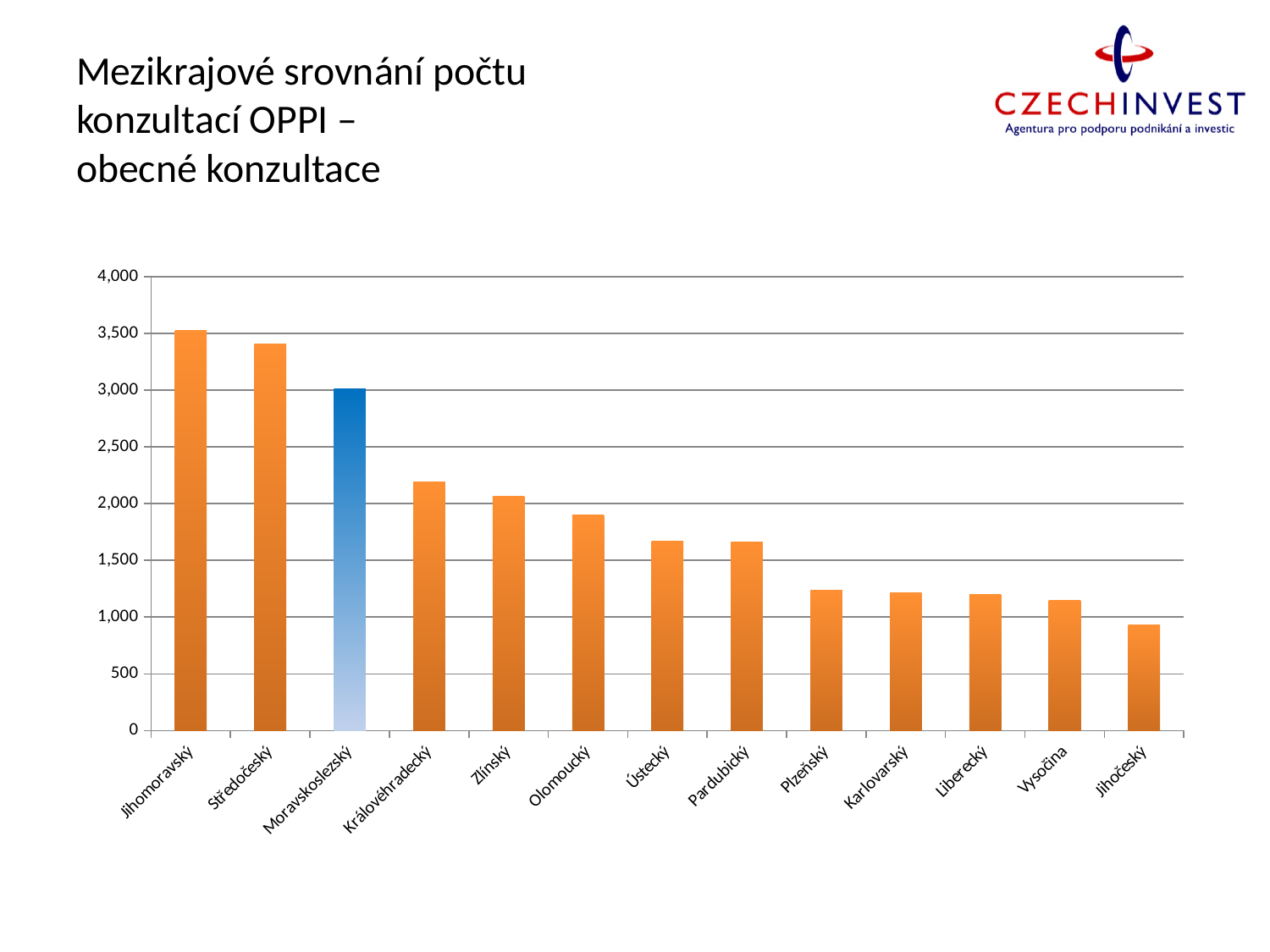
Which region has the highest number of consultations in the chart? Jihomoravský Is the value for Plzeňský greater or less than 1,500? less What kind of chart is shown on the slide? bar chart Is the value for Jihočeský greater or less than 1,000? less Which has a larger value, Zlínský or Olomoucký? Zlínský Which region has the lowest number of consultations in the chart? Jihočeský Is the value for Jihomoravský greater or less than 3,000? greater How many regions (categories) are shown on the x axis of the chart? 13 Do the bar values rise or fall from left to right along the x axis? fall Which region's bar is coloured blue instead of orange? Moravskoslezský